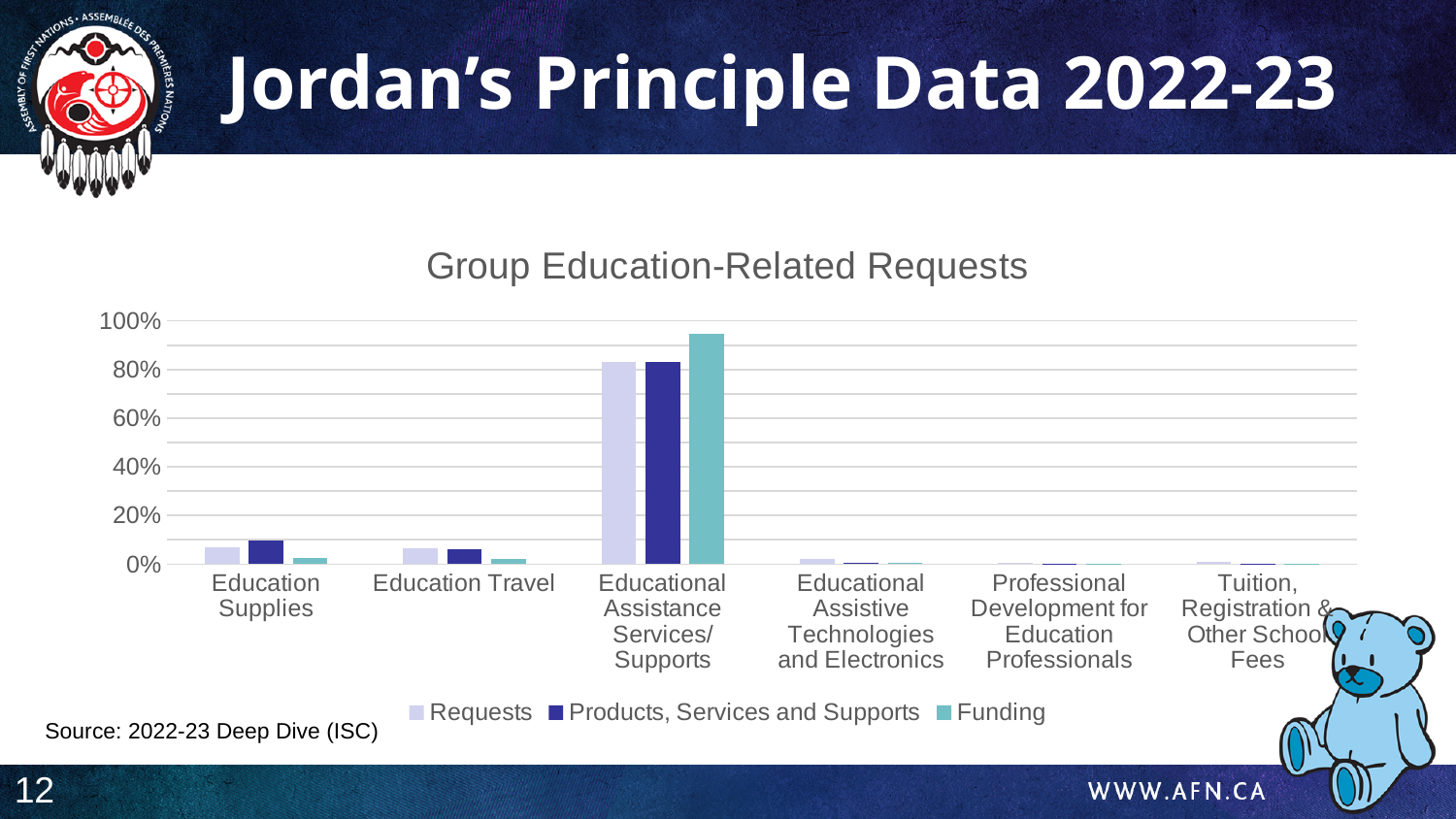
What kind of chart is shown on the slide? bar chart Is the Requests value for Education Supplies greater or less than 20%? less Which is larger: the Funding value for Education Supplies or the Funding value for Educational Assistance Services/Supports? Educational Assistance Services/Supports Which is larger: the Requests value for Educational Assistance Services/Supports or the Requests value for Education Travel? Educational Assistance Services/Supports How many categories are shown on the x axis of the chart? 6 Is the Funding value for Educational Assistance Services/Supports greater or less than 80%? greater Which category has the highest Requests value? Educational Assistance Services/Supports Which series is shown in the darkest blue colour in the legend? Products, Services and Supports Which category has the highest Funding value? Educational Assistance Services/Supports Is the Products, Services and Supports value for Educational Assistance Services/Supports greater or less than 60%? greater What is the title of the chart? Group Education-Related Requests How many series does the chart's legend list? 3